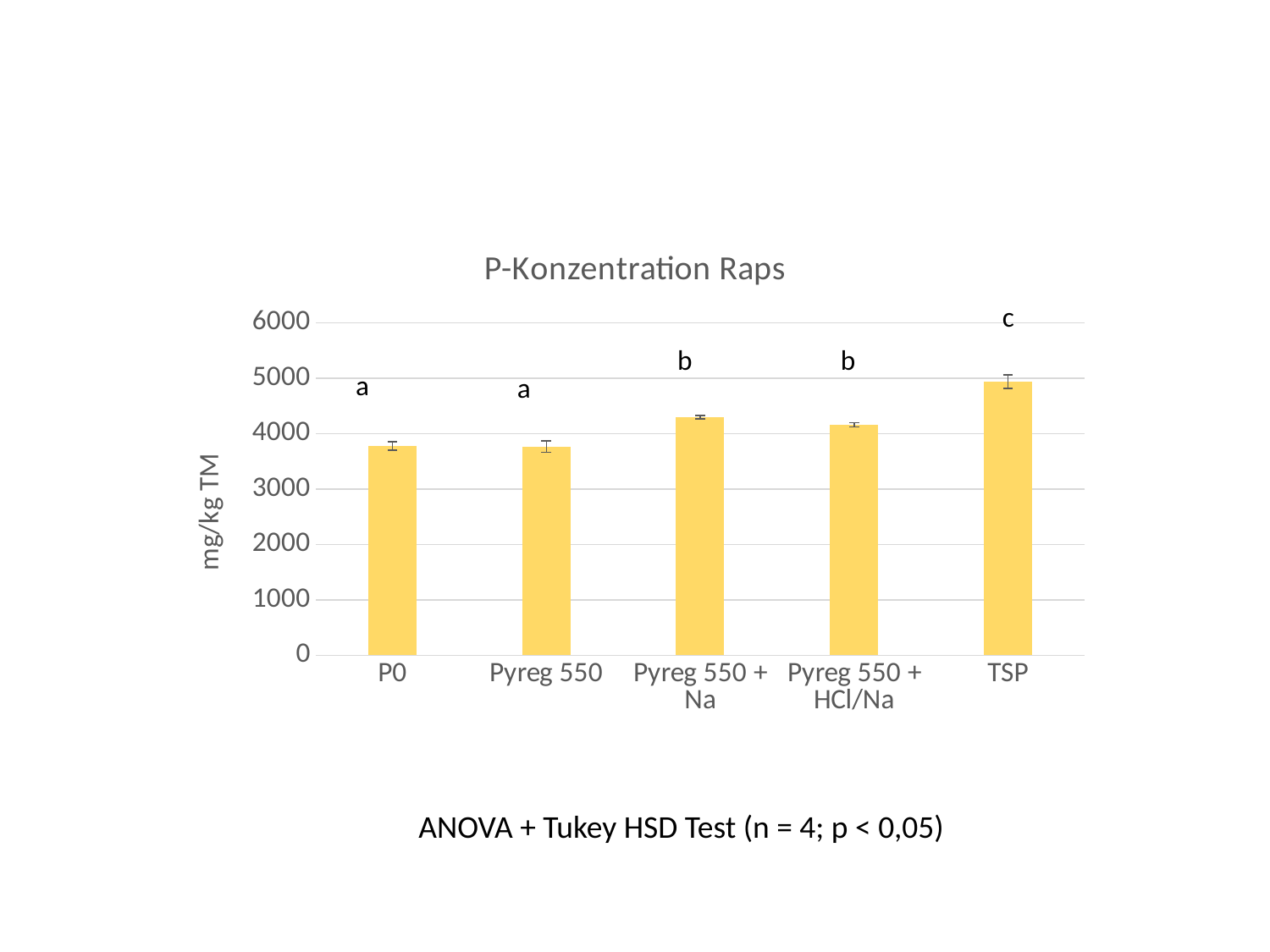
Is the value for TSP greater or less than 4000? greater What kind of chart is shown on the slide? bar chart Is the value for Pyreg 550 greater or less than 3000? greater What is the label on the vertical axis of the chart? mg/kg TM Which category has the highest value in the chart? TSP Which is larger, the value for TSP or the value for P0? TSP Which is larger, the value for Pyreg 550 + Na or the value for Pyreg 550? Pyreg 550 + Na Which significance letter is shown above the TSP bar? c How many categories (bars) are shown in the chart? 5 Is the value for Pyreg 550 + Na greater or less than 4000? greater What is the title of the chart? P-Konzentration Raps